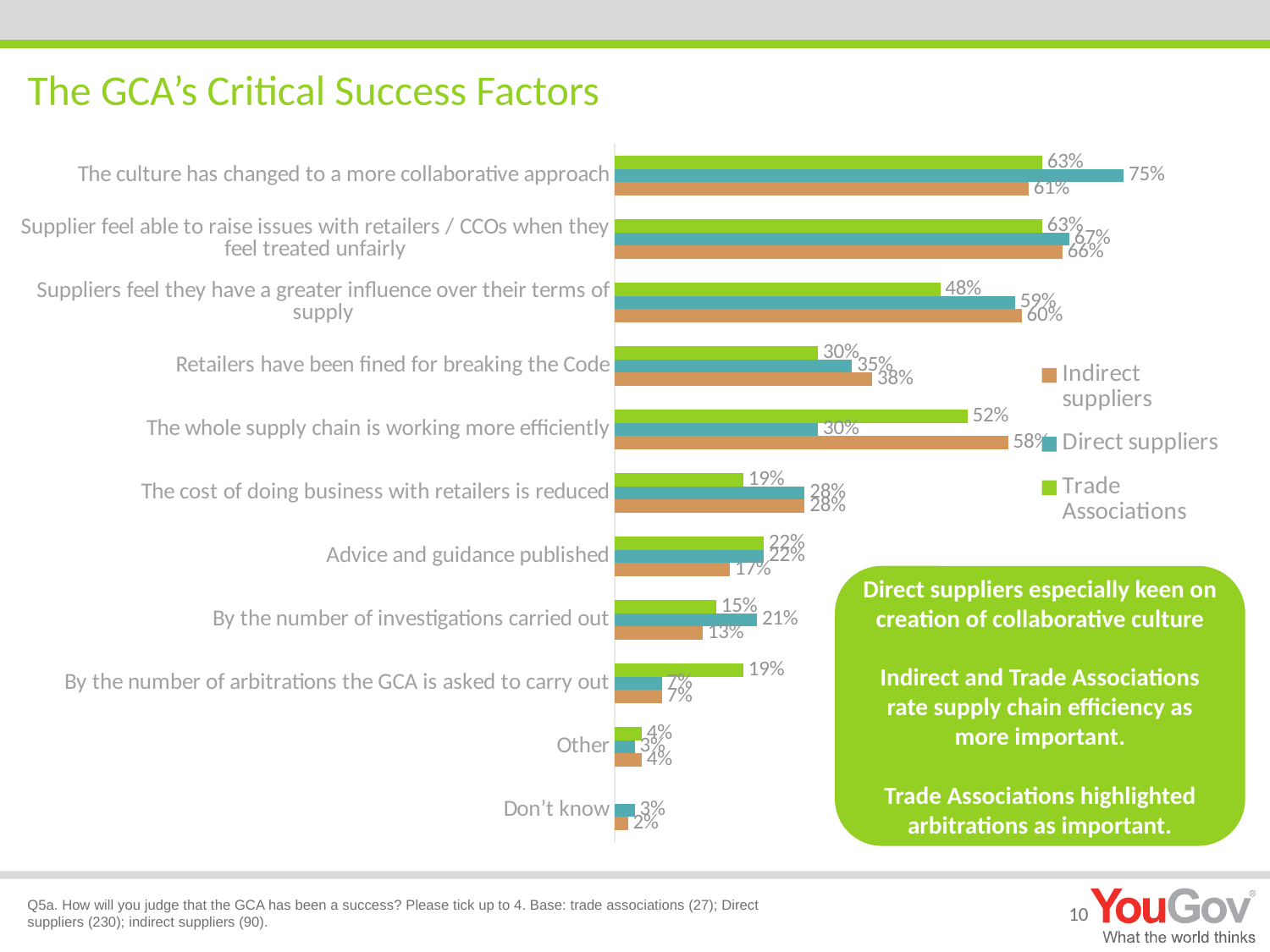
Which category has the highest value for Direct suppliers? The culture has changed to a more collaborative approach How many series does the legend list? 3 What type of chart is shown on the slide? Bar chart For 'By the number of investigations carried out', what is the difference between the Direct suppliers and Indirect suppliers values? 8 percentage points What is the Indirect suppliers value for 'The whole supply chain is working more efficiently'? 58% For 'The whole supply chain is working more efficiently', which is larger: the Indirect suppliers value or the Direct suppliers value? Indirect suppliers What is the Trade Associations value for 'Suppliers feel they have a greater influence over their terms of supply'? 48% For 'The culture has changed to a more collaborative approach', how much higher is the Direct suppliers value than the Indirect suppliers value? 14 percentage points How many categories are shown on the chart? 11 What is the Trade Associations value for 'By the number of arbitrations the GCA is asked to carry out'? 19% What colour represents Trade Associations in the chart? Green What percentage of Direct suppliers chose 'The culture has changed to a more collaborative approach'? 75%